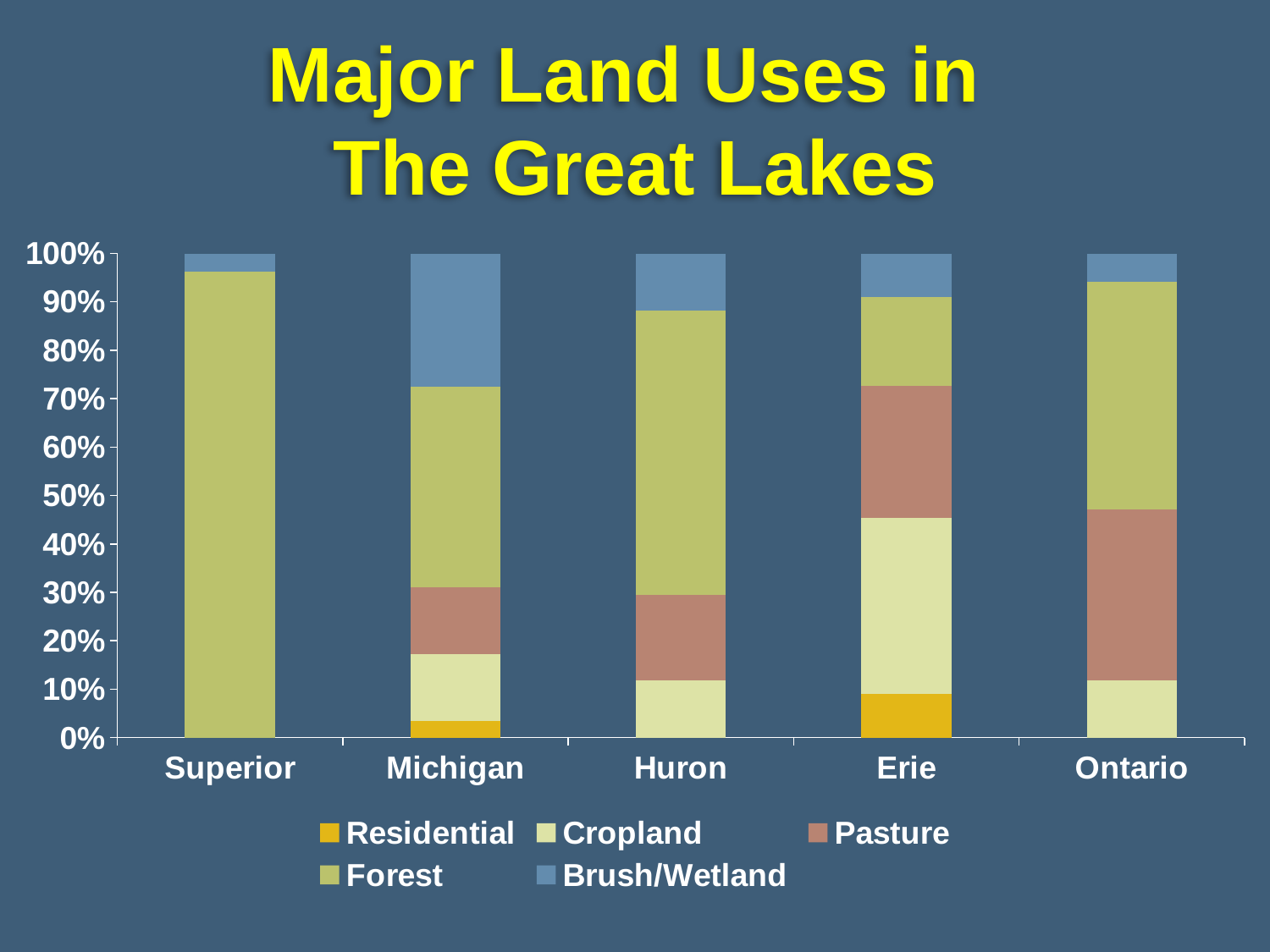
How many lakes are shown on the x axis? 5 Which lake has the smallest Forest share? Erie What kind of chart is shown on the slide? bar chart Which lake has the largest Forest share? Superior Is the Forest share for Superior greater or less than 90%? greater Which lake has the largest Brush/Wetland share? Michigan Is the Brush/Wetland share for Michigan greater or less than 20%? greater Which lake has the largest Cropland share? Erie Is the Pasture share for Ontario greater or less than 30%? greater What is the title of the chart? Major Land Uses in The Great Lakes How many land-use series does the legend list? 5 Which lake has the larger Forest share, Huron or Michigan? Huron